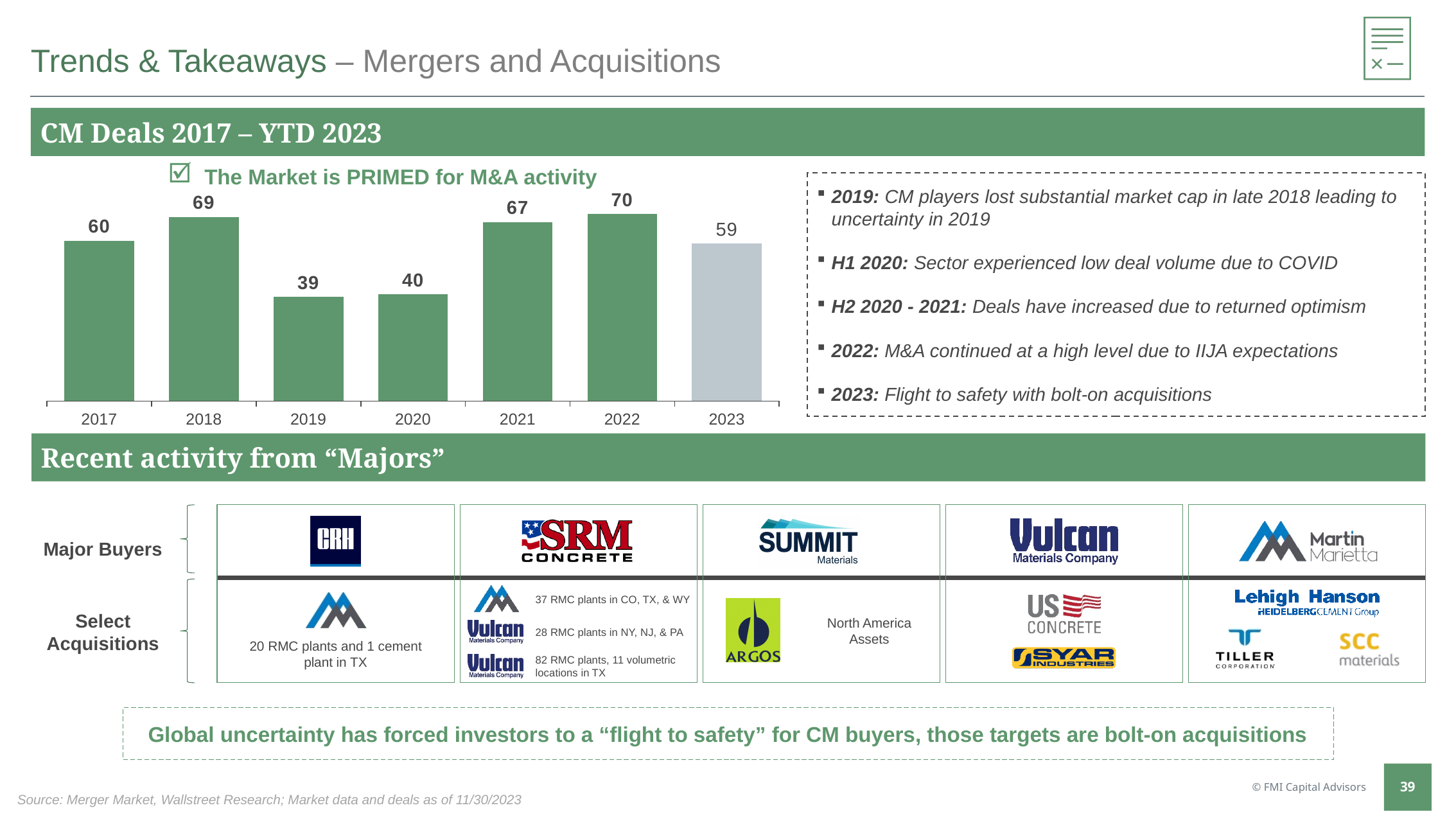
Which year has the highest number of CM deals? 2022 What is the difference in CM deals between 2022 and 2019? 31 What is the value shown for 2023 in the CM Deals chart? 59 What is the difference in CM deals between 2018 and 2017? 9 Did the number of CM deals rise or fall from 2018 to 2019? Fall How many CM deals were there in 2017? 60 Which bar in the CM Deals chart is coloured grey instead of green? 2023 How many years are shown in the CM Deals chart? 7 What is the title of the chart section showing deal counts by year? CM Deals 2017 – YTD 2023 Which year has the lowest number of CM deals? 2019 What type of chart is used to show CM Deals 2017 – YTD 2023? Bar chart Which year had more CM deals, 2020 or 2021? 2021